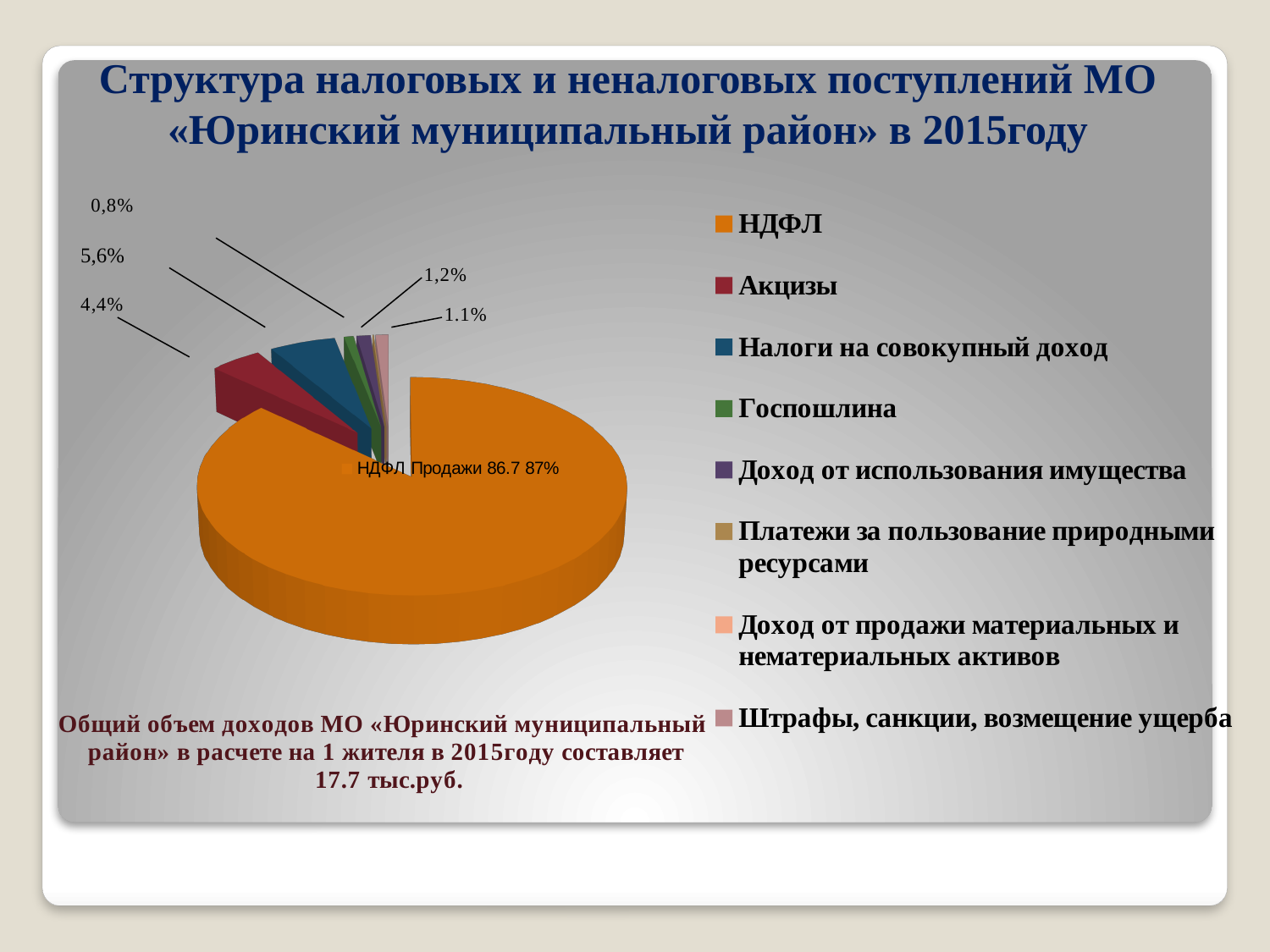
Which category has the largest slice of the pie? НДФЛ What is the smallest percentage label shown on the pie chart? 0,8% How many entries does the legend list? 8 What kind of chart is shown on the slide? pie chart What colour is the НДФЛ slice in the pie chart? orange Is the share for НДФЛ greater or less than 50%? greater Which year does the chart title refer to? 2015 Which is larger, the share for НДФЛ or the share for Акцизы? НДФЛ